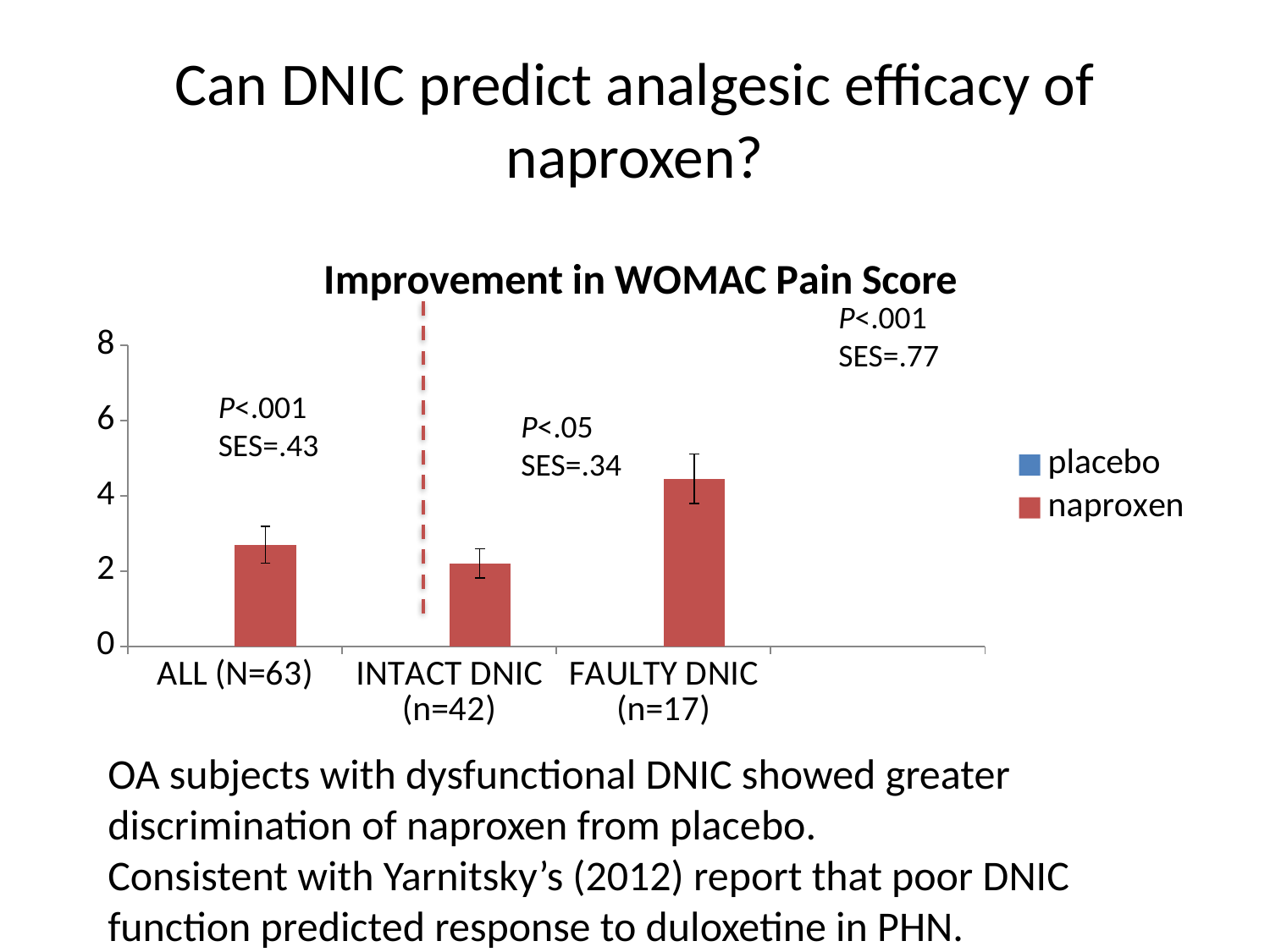
How many categories are shown on the x axis of the chart? 3 Is the naproxen bar for INTACT DNIC (n=42) greater or less than 4? less Which category has the highest naproxen bar? FAULTY DNIC (n=17) What kind of chart is shown on the slide? bar chart What is the title of the chart? Improvement in WOMAC Pain Score Which is larger, the naproxen bar for ALL (N=63) or for INTACT DNIC (n=42)? ALL (N=63) How many series does the chart legend list? 2 What P value is printed above the INTACT DNIC (n=42) bar? P<.05 Is the naproxen bar for ALL (N=63) greater or less than 4? less Which category has the lowest naproxen bar? INTACT DNIC (n=42) Is the naproxen bar for FAULTY DNIC (n=17) greater or less than 4? greater What SES value is printed above the FAULTY DNIC (n=17) bar? SES=.77